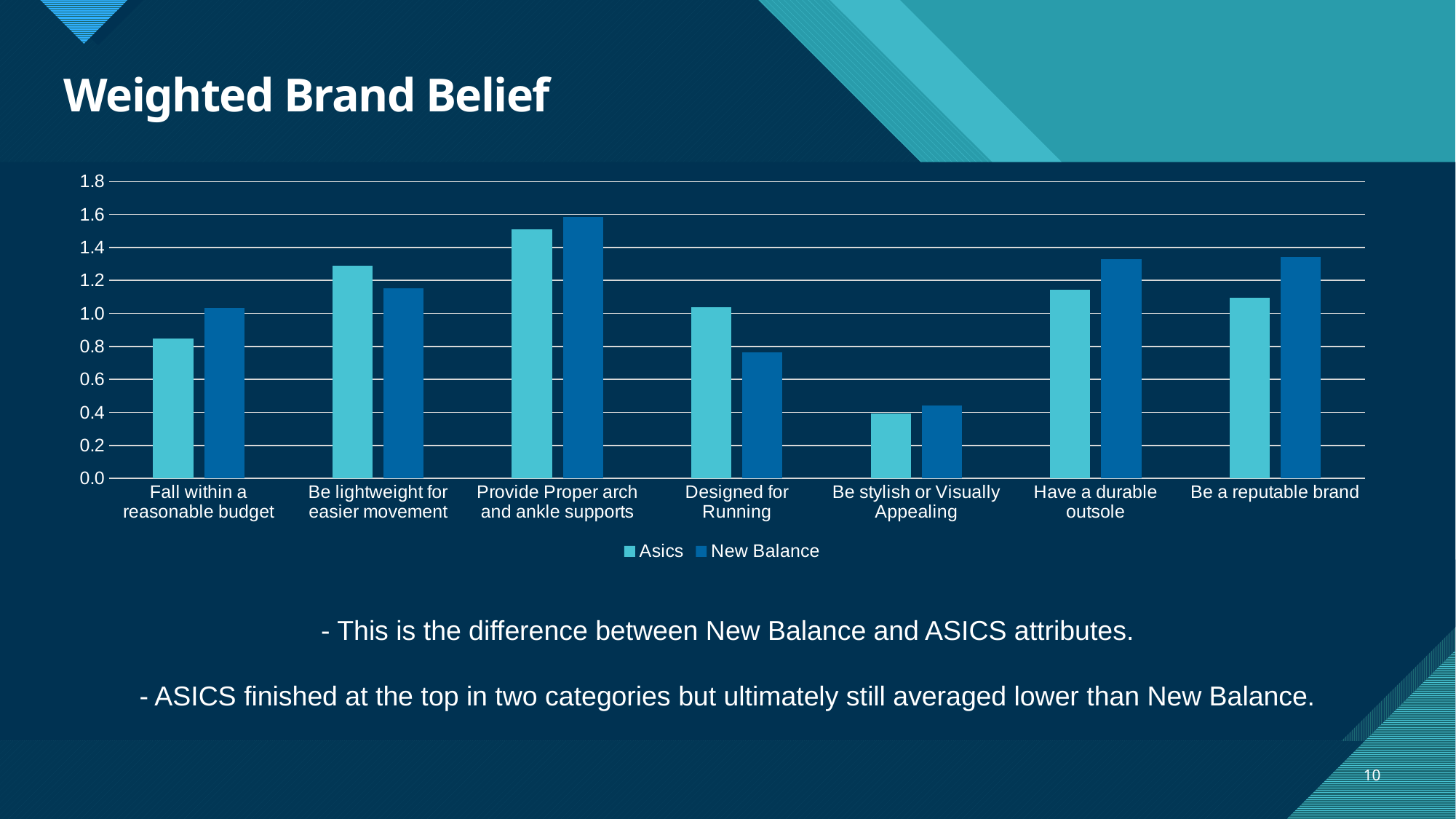
Is the New Balance value for 'Be a reputable brand' greater or less than 1.2? greater For 'Have a durable outsole', which series has the larger value, Asics or New Balance? New Balance For 'Designed for Running', which series has the larger value, Asics or New Balance? Asics Which category has the lowest New Balance value? Be stylish or Visually Appealing How many series does the legend list? 2 Which category has the lowest Asics value? Be stylish or Visually Appealing What kind of chart is shown on the slide? bar chart What is the title of the chart on the slide? Weighted Brand Belief How many categories are shown on the x axis? 7 Is the Asics value for 'Provide Proper arch and ankle supports' greater or less than 1.4? greater Which category has the highest Asics value? Provide Proper arch and ankle supports Is the Asics value for 'Fall within a reasonable budget' greater or less than 1.0? less